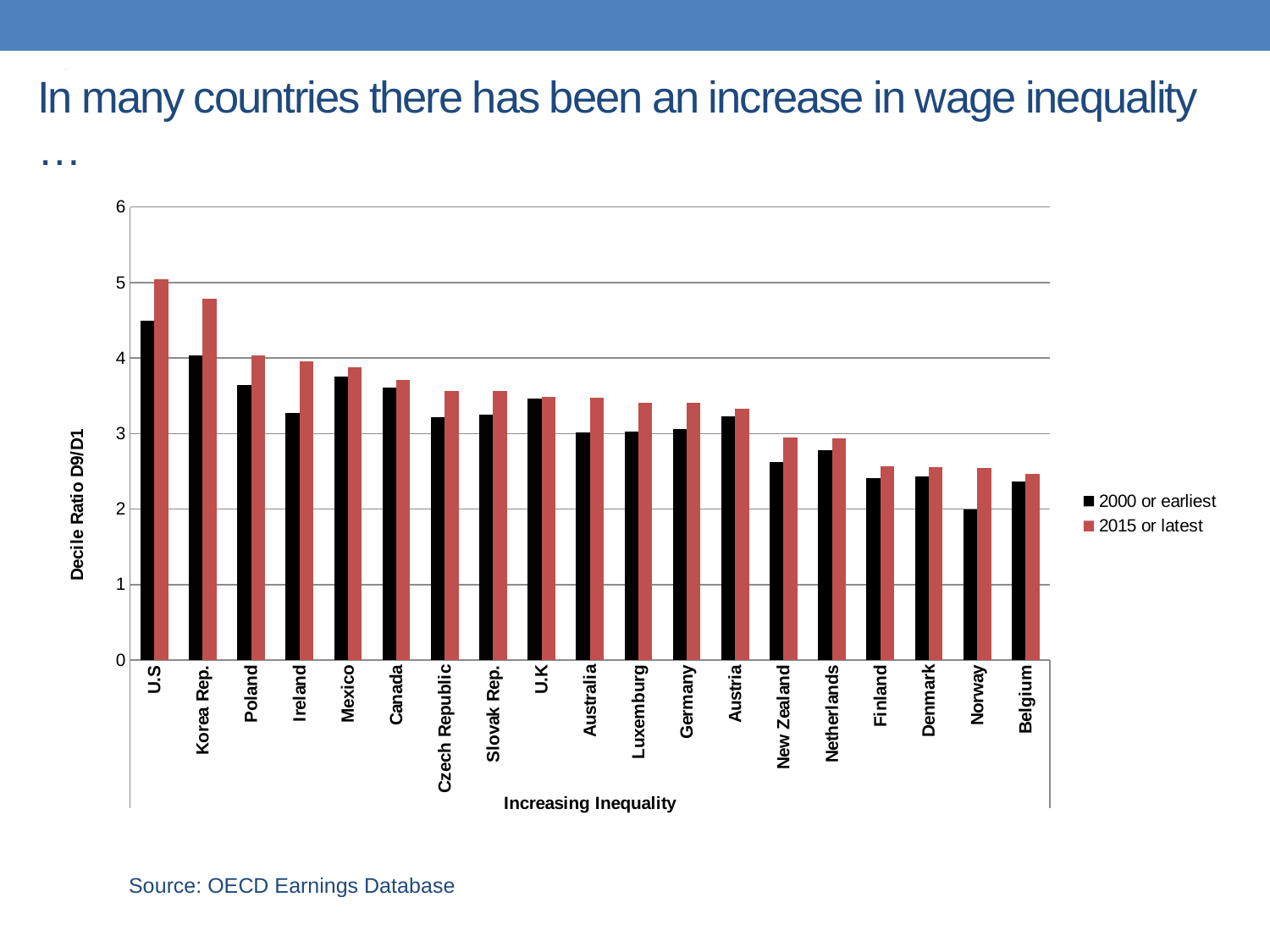
Which country has the lowest value for the 2000 or earliest series? Norway For Ireland, which is larger: the 2000 or earliest value or the 2015 or latest value? 2015 or latest Which country has the highest value for the 2015 or latest series? U.S Which has the larger 2000 or earliest value, Norway or Belgium? Belgium Is the 2000 or earliest value for New Zealand greater or less than 3? less Is the 2000 or earliest value for the U.S greater or less than 4? greater How many series does the legend list? 2 Is the 2000 or earliest value for Finland greater or less than 3? less How many countries are shown on the x axis? 19 What kind of chart is shown on the slide? bar chart What is the title of the vertical axis? Decile Ratio D9/D1